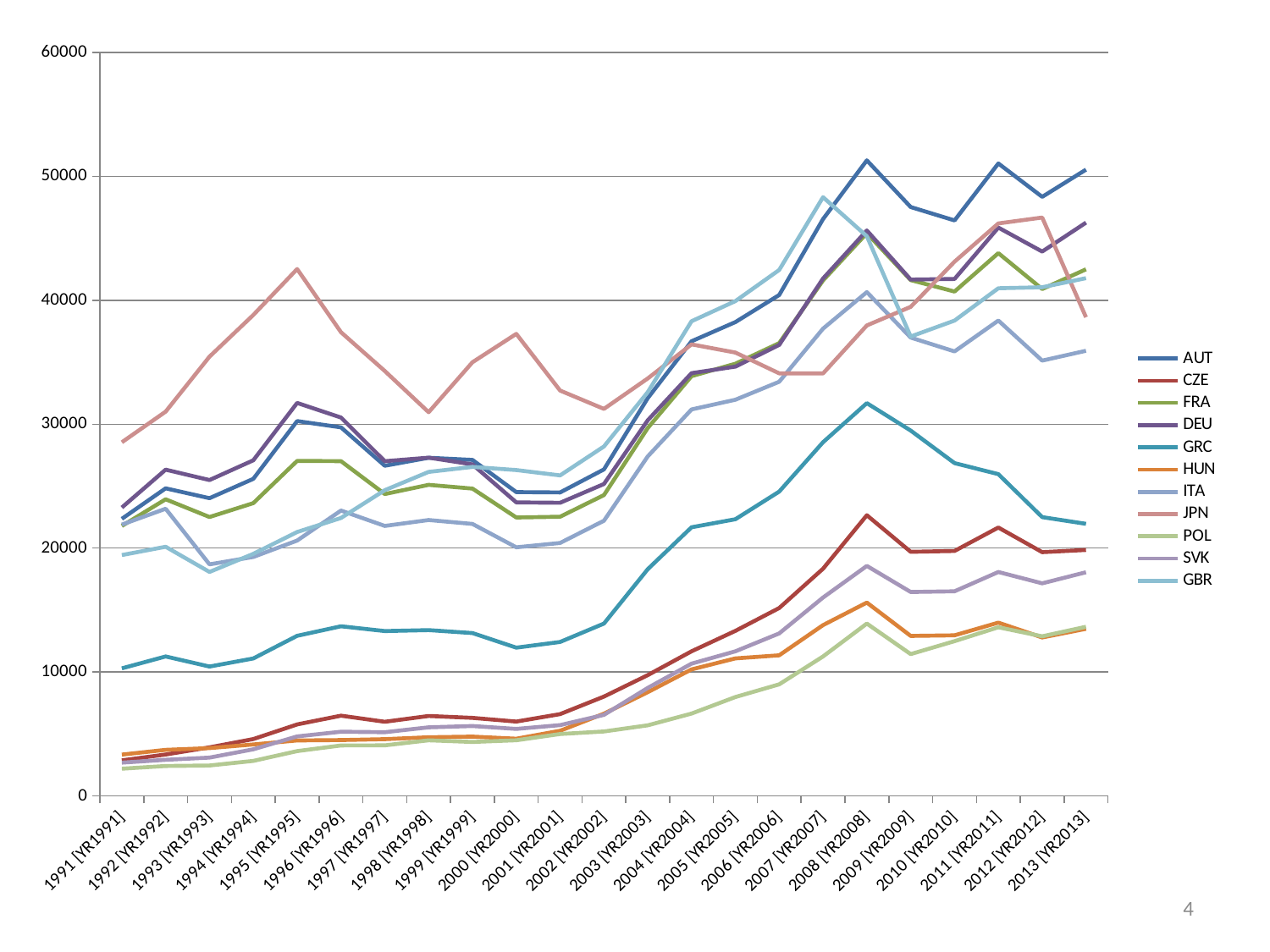
Is the value for GRC in 2008 [YR2008] greater or less than 30000? greater What kind of chart is shown on the slide? line chart How many series does the legend list? 11 Is the value for POL in 1991 [YR1991] greater or less than 10000? less Is the value for JPN in 1995 [YR1995] greater or less than 40000? greater Which series has the highest value in 1995 [YR1995]? JPN Does the value for GRC rise or fall from 2008 [YR2008] to 2013 [YR2013]? fall In 2008 [YR2008], which is larger, the value for GRC or the value for CZE? GRC How many years are plotted along the x axis? 23 Which series has the highest value in 2013 [YR2013]? AUT